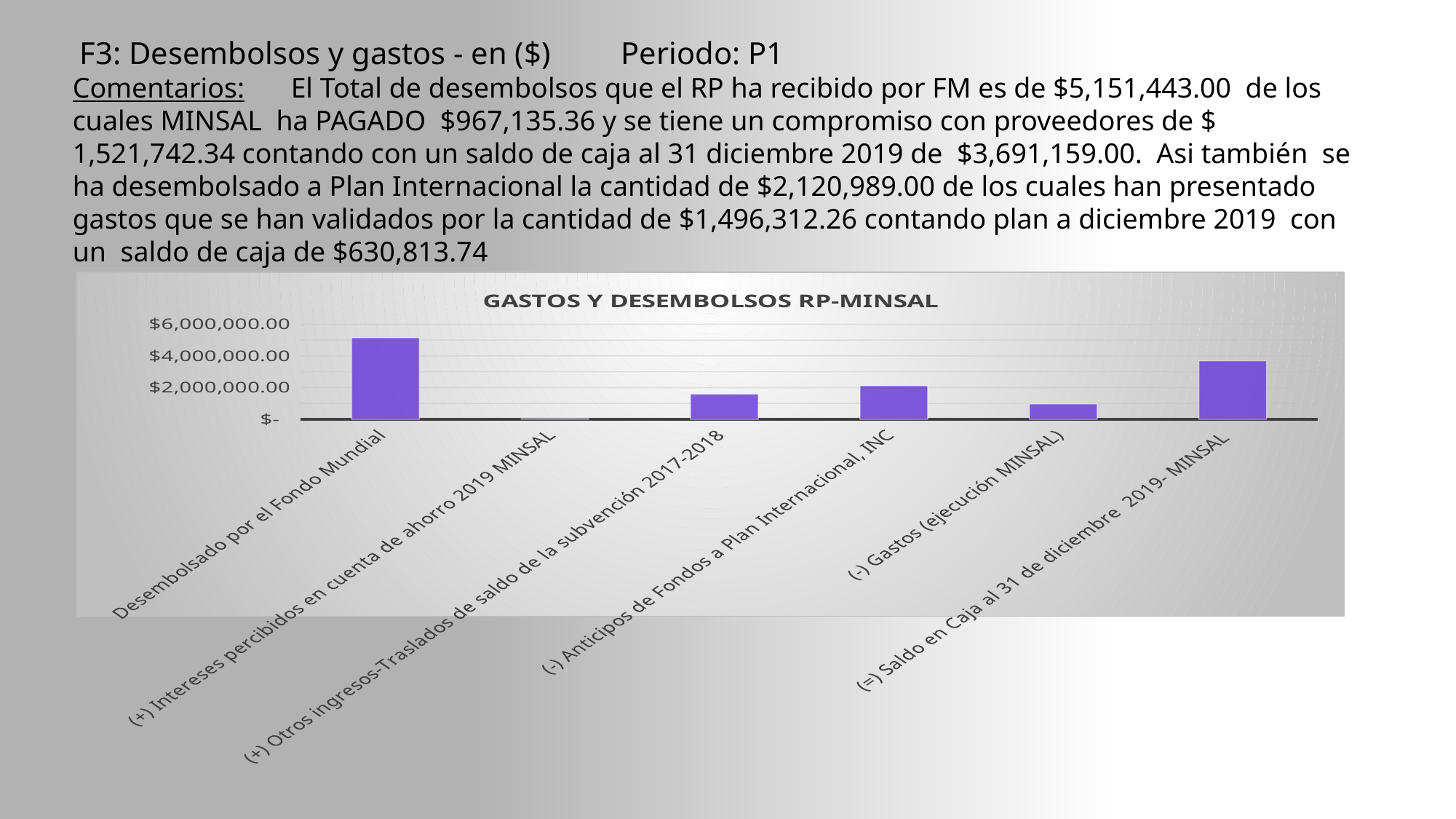
Is the value for (=) Saldo en Caja al 31 de diciembre 2019- MINSAL greater or less than $2,000,000.00? greater How many categories are shown on the x axis of the chart? 6 Which is larger: the bar for Desembolsado por el Fondo Mundial or the bar for (=) Saldo en Caja al 31 de diciembre 2019- MINSAL? Desembolsado por el Fondo Mundial Which is larger: the bar for (-) Anticipos de Fondos a Plan Internacional, INC or the bar for (-) Gastos (ejecución MINSAL)? (-) Anticipos de Fondos a Plan Internacional, INC Is the value for Desembolsado por el Fondo Mundial greater or less than $4,000,000.00? greater Is the value for (+) Otros ingresos-Traslados de saldo de la subvención 2017-2018 greater or less than $2,000,000.00? less Which category has the highest bar in the chart? Desembolsado por el Fondo Mundial What colour are the bars in the chart? purple Which category has the lowest bar in the chart? (+) Intereses percibidos en cuenta de ahorro 2019 MINSAL What is the title of the chart? GASTOS Y DESEMBOLSOS RP-MINSAL What kind of chart is shown on the slide? bar chart